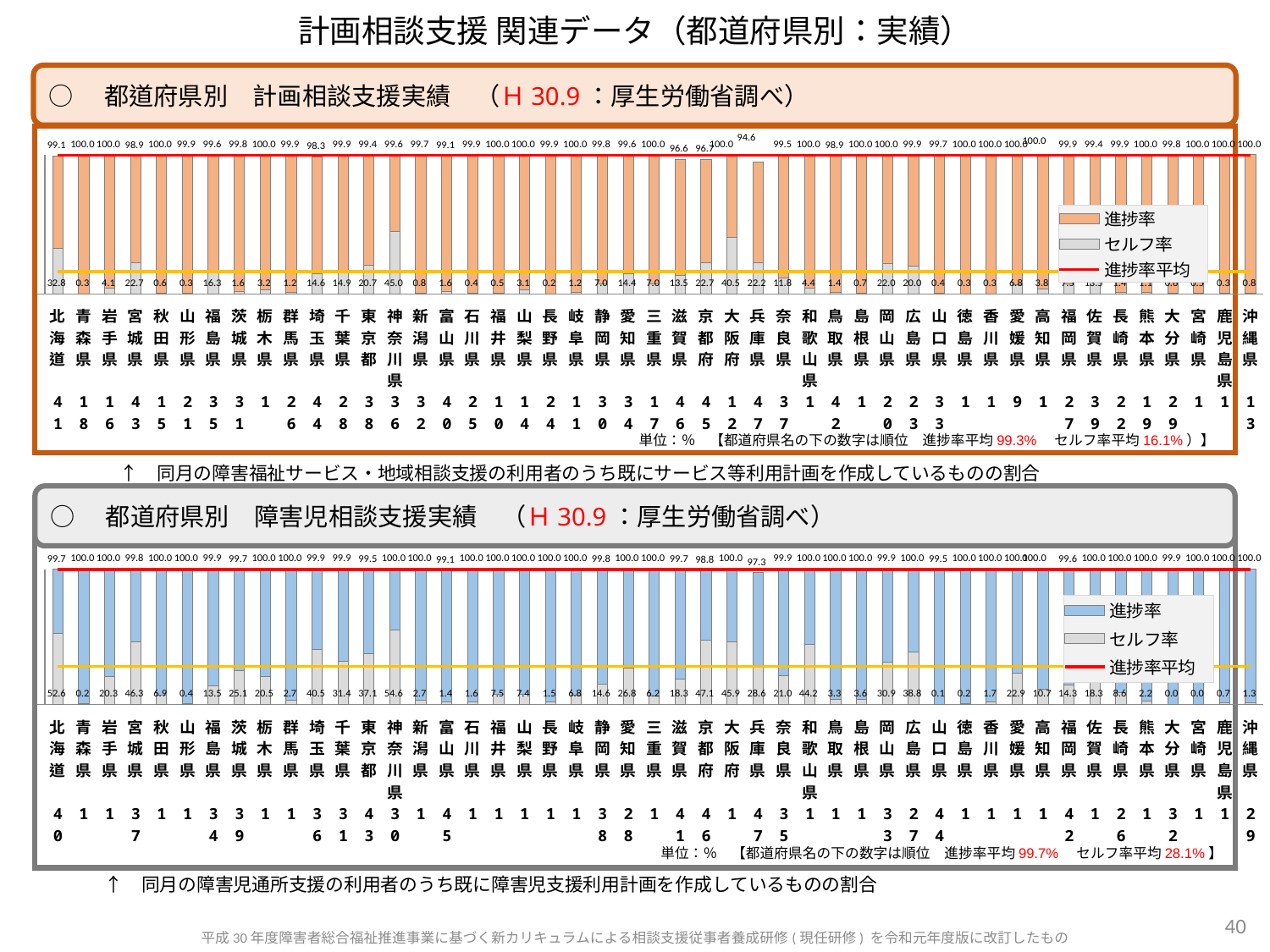
In the top chart (都道府県別 計画相談支援実績), what is the 進捗率平均 stated on the slide? 99.3% How many entries does the legend of the bottom chart (都道府県別 障害児相談支援実績) list? 3 In the bottom chart (都道府県別 障害児相談支援実績), what is the difference between the セルフ率 of 神奈川県 (54.6) and 北海道 (52.6)? 2.0 In the bottom chart (都道府県別 障害児相談支援実績), what is the セルフ率平均 stated on the slide? 28.1% In the top chart (都道府県別 計画相談支援実績), what is the セルフ率 value for 神奈川県? 45.0 In the top chart (都道府県別 計画相談支援実績), which has the larger セルフ率, 大阪府 or 京都府? 大阪府 What kind of chart is the top chart (都道府県別 計画相談支援実績)? bar chart In the bottom chart (都道府県別 障害児相談支援実績), what is the セルフ率 value for 北海道? 52.6 In the top chart (都道府県別 計画相談支援実績), which prefecture has the lowest 進捗率? 兵庫 In the top chart (都道府県別 計画相談支援実績), what is the difference between the セルフ率 of 神奈川県 (45.0) and 北海道 (32.8)? 12.2